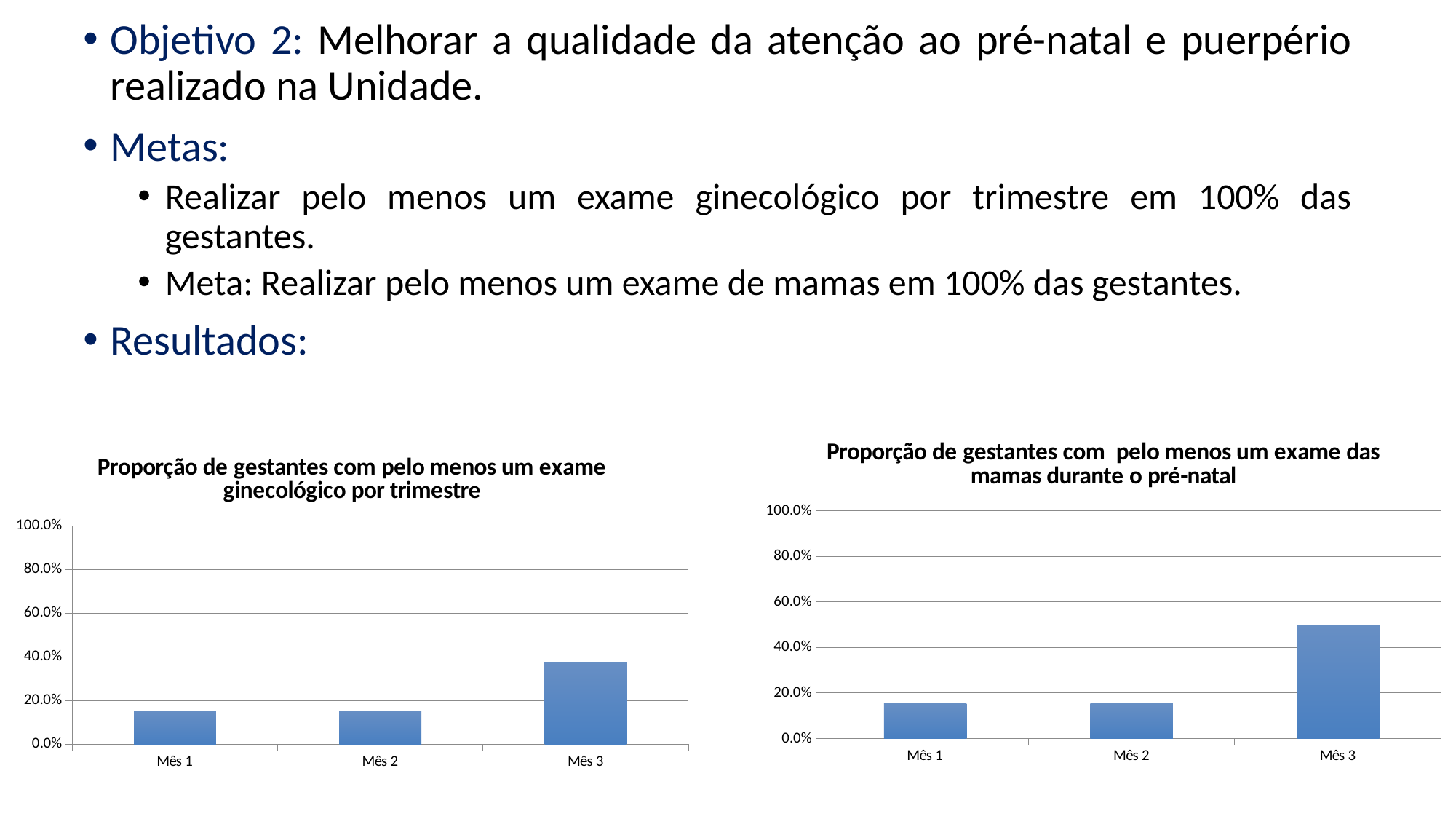
In the chart titled "Proporção de gestantes com pelo menos um exame das mamas durante o pré-natal", which is larger, the value for Mês 1 or the value for Mês 3? Mês 3 In the chart titled "Proporção de gestantes com pelo menos um exame das mamas durante o pré-natal", which month has the highest value? Mês 3 In the chart titled "Proporção de gestantes com pelo menos um exame ginecológico por trimestre", which is larger, the value for Mês 2 or the value for Mês 3? Mês 3 In the chart titled "Proporção de gestantes com pelo menos um exame ginecológico por trimestre", how many categories are plotted on the x axis? 3 In the chart titled "Proporção de gestantes com pelo menos um exame ginecológico por trimestre", what kind of chart is shown? bar chart In the chart titled "Proporção de gestantes com pelo menos um exame ginecológico por trimestre", is the value for Mês 1 greater or less than 20.0%? less In the chart titled "Proporção de gestantes com pelo menos um exame das mamas durante o pré-natal", is the value for Mês 2 greater or less than 20.0%? less In the chart titled "Proporção de gestantes com pelo menos um exame das mamas durante o pré-natal", do the values rise or fall from Mês 1 to Mês 3? rise In the chart titled "Proporção de gestantes com pelo menos um exame ginecológico por trimestre", which month has the highest value? Mês 3 In the chart titled "Proporção de gestantes com pelo menos um exame ginecológico por trimestre", is the value for Mês 3 greater or less than 20.0%? greater What is the highest value shown on the y axis of the chart on the right of the slide? 100.0%